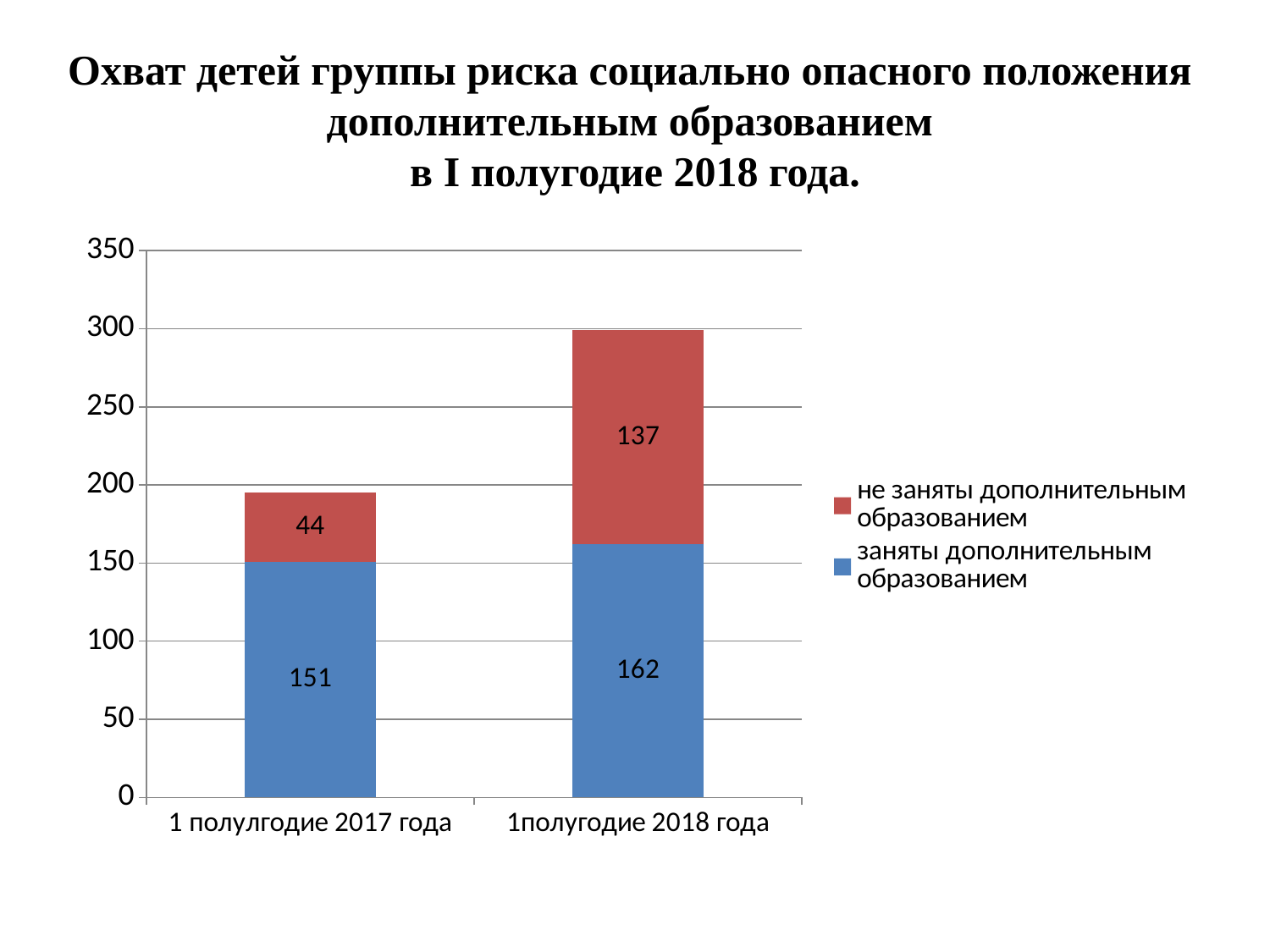
What is the value for "заняты дополнительным образованием" in "1полугодие 2018 года"? 162 What is the total of the stacked bar for "1 полулгодие 2017 года"? 195 What is the difference between the "не заняты дополнительным образованием" values for 2018 and 2017? 93 What kind of chart is shown on the slide? Stacked bar chart What is the total of the stacked bar for "1полугодие 2018 года"? 299 What is the value for "не заняты дополнительным образованием" in "1полугодие 2018 года"? 137 What is the value for "не заняты дополнительным образованием" in "1 полулгодие 2017 года"? 44 Which colour represents "заняты дополнительным образованием"? Blue How many series does the legend list? 2 What is the value for "заняты дополнительным образованием" in "1 полулгодие 2017 года"? 151 Which period has the larger value for "не заняты дополнительным образованием"? 1полугодие 2018 года How many categories are shown on the x axis? 2